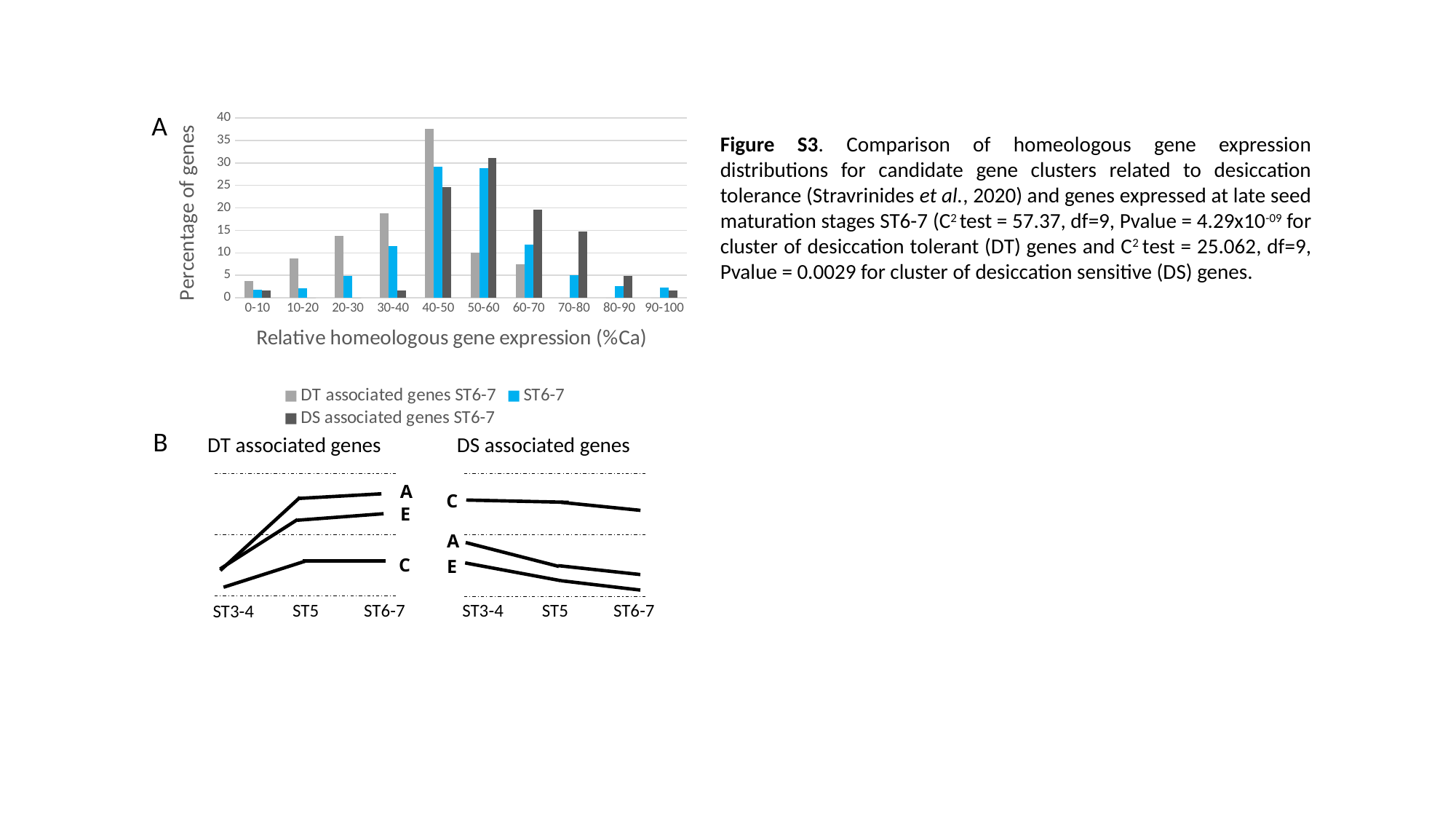
In panel A, what is the y-axis title? Percentage of genes In panel A, what is the x-axis title? Relative homeologous gene expression (%Ca) In panel A, in the 70-80 bin, which is larger: DS associated genes ST6-7 or ST6-7? DS associated genes ST6-7 In panel A, how many series does the legend list? 3 In panel A, which bin has the highest value for DS associated genes ST6-7? 50-60 In panel A, is the value for DT associated genes ST6-7 in the 40-50 bin greater or less than 35? greater In panel B, do the lines for DS associated genes rise or fall from ST3-4 to ST6-7? fall In panel A, how many expression bins are shown on the x axis? 10 In panel A, is the value for ST6-7 in the 60-70 bin greater or less than 10? greater In panel A, which bin has the highest value for DT associated genes ST6-7? 40-50 In panel A, in the 30-40 bin, which is larger: DT associated genes ST6-7 or DS associated genes ST6-7? DT associated genes ST6-7 What kind of chart is panel A? bar chart